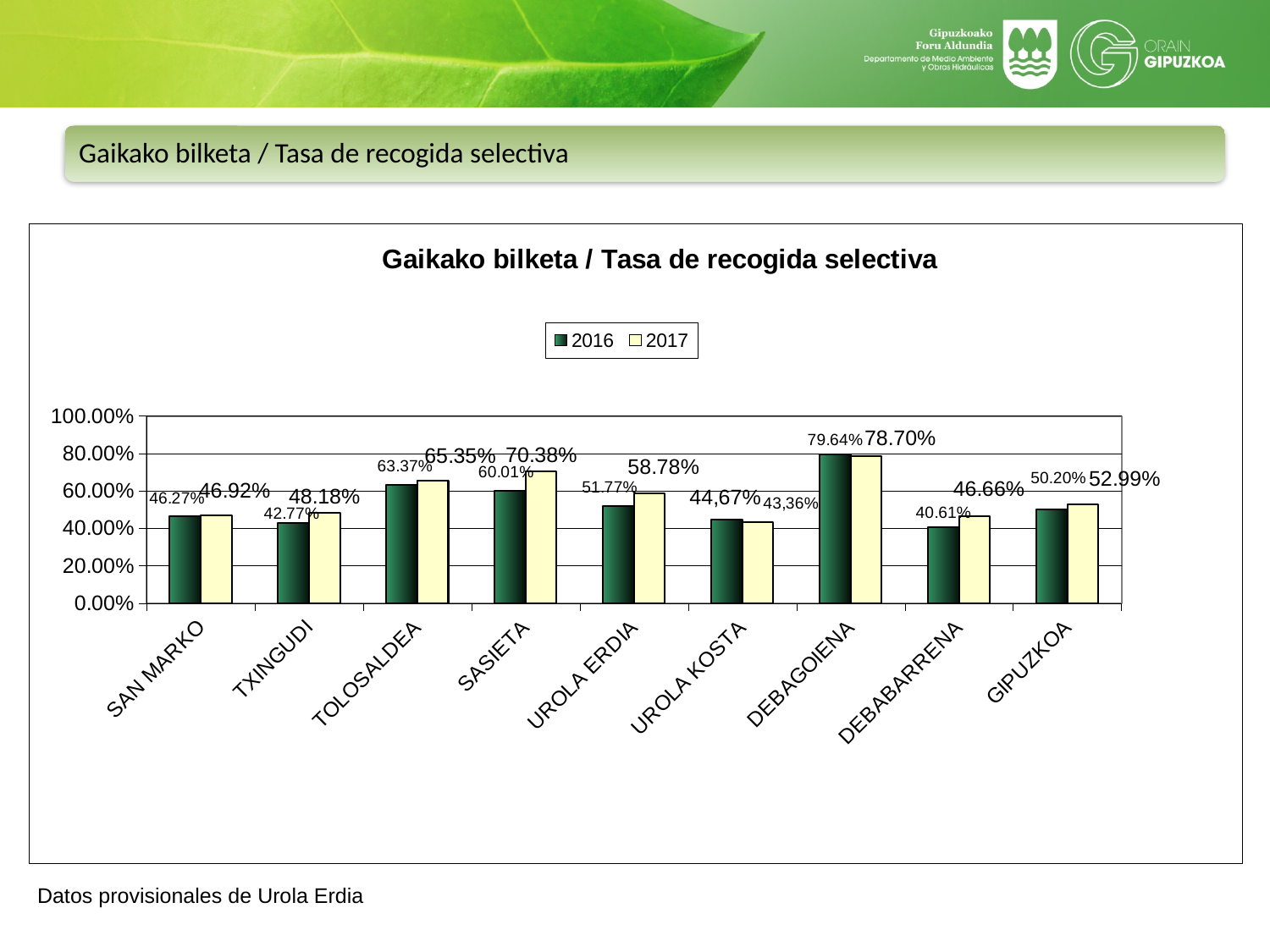
How many series does the legend list? 2 What is the 2016 value for UROLA KOSTA? 44,67% What is the difference between the 2017 and 2016 values for SASIETA? 10.37% Which category has the lowest 2017 value? UROLA KOSTA What is the 2016 value for DEBABARRENA? 40.61% What kind of chart is shown? Bar chart What is the 2017 value for GIPUZKOA? 52.99% What is the 2017 value for SASIETA? 70.38% Which is larger for DEBAGOIENA, the 2016 value or the 2017 value? 2016 How many categories are shown on the x axis? 9 What is the title of the chart? Gaikako bilketa / Tasa de recogida selectiva Which category has the highest 2016 value? DEBAGOIENA